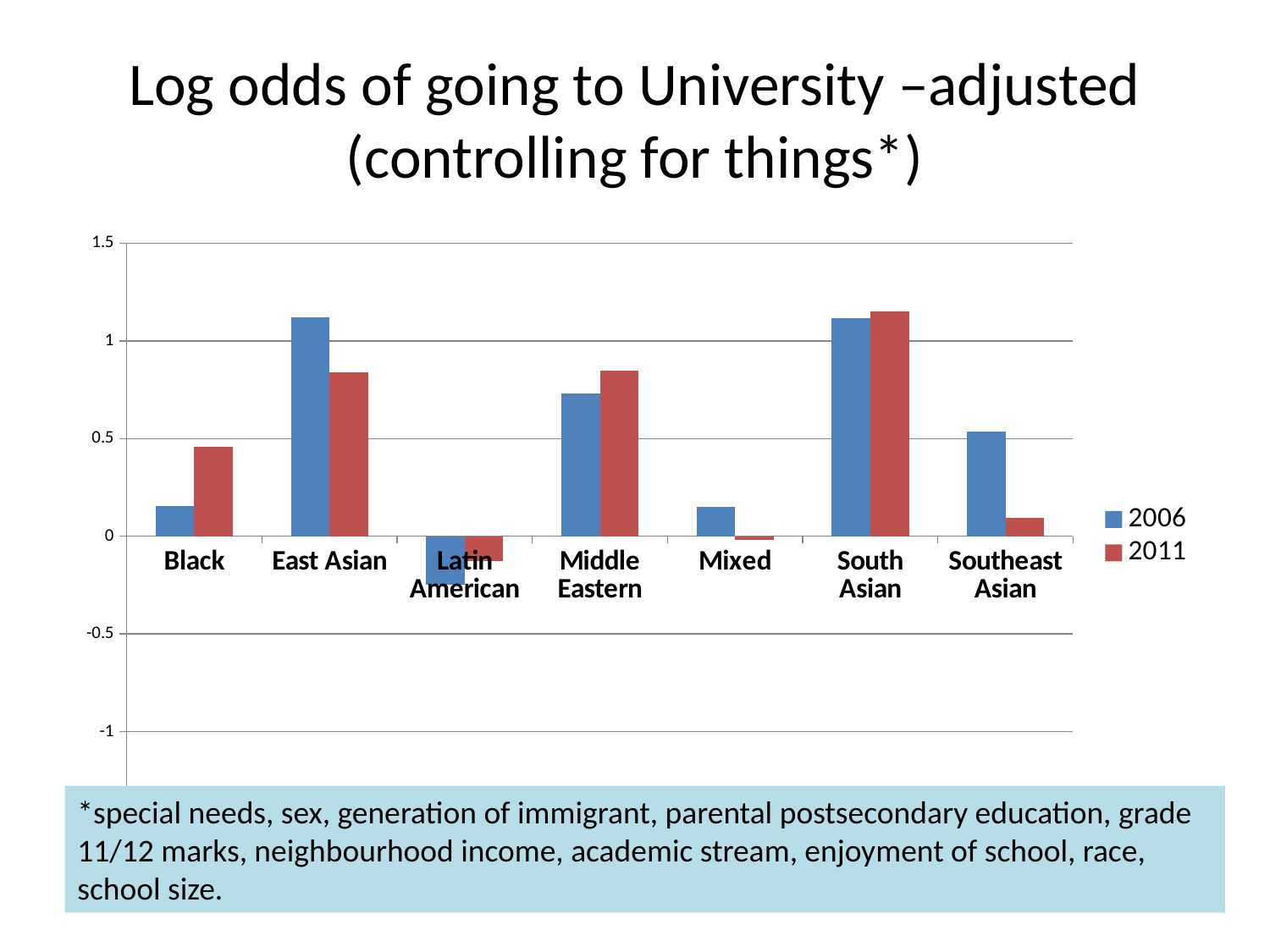
Is the 2006 value for Latin American greater or less than 0? less For Black, which year has the larger value, 2006 or 2011? 2011 What kind of chart is shown on the slide? Bar chart Which category has the highest 2011 value? South Asian How many categories are shown on the x axis of the chart? 7 Is the 2011 value for Middle Eastern greater or less than 0.5? greater Which series are listed in the chart legend? 2006 and 2011 How many series does the legend list? 2 Is the 2011 value for Southeast Asian greater or less than 0.5? less What is the title of the slide containing the chart? Log odds of going to University –adjusted (controlling for things*) Which category has the lowest 2006 value? Latin American